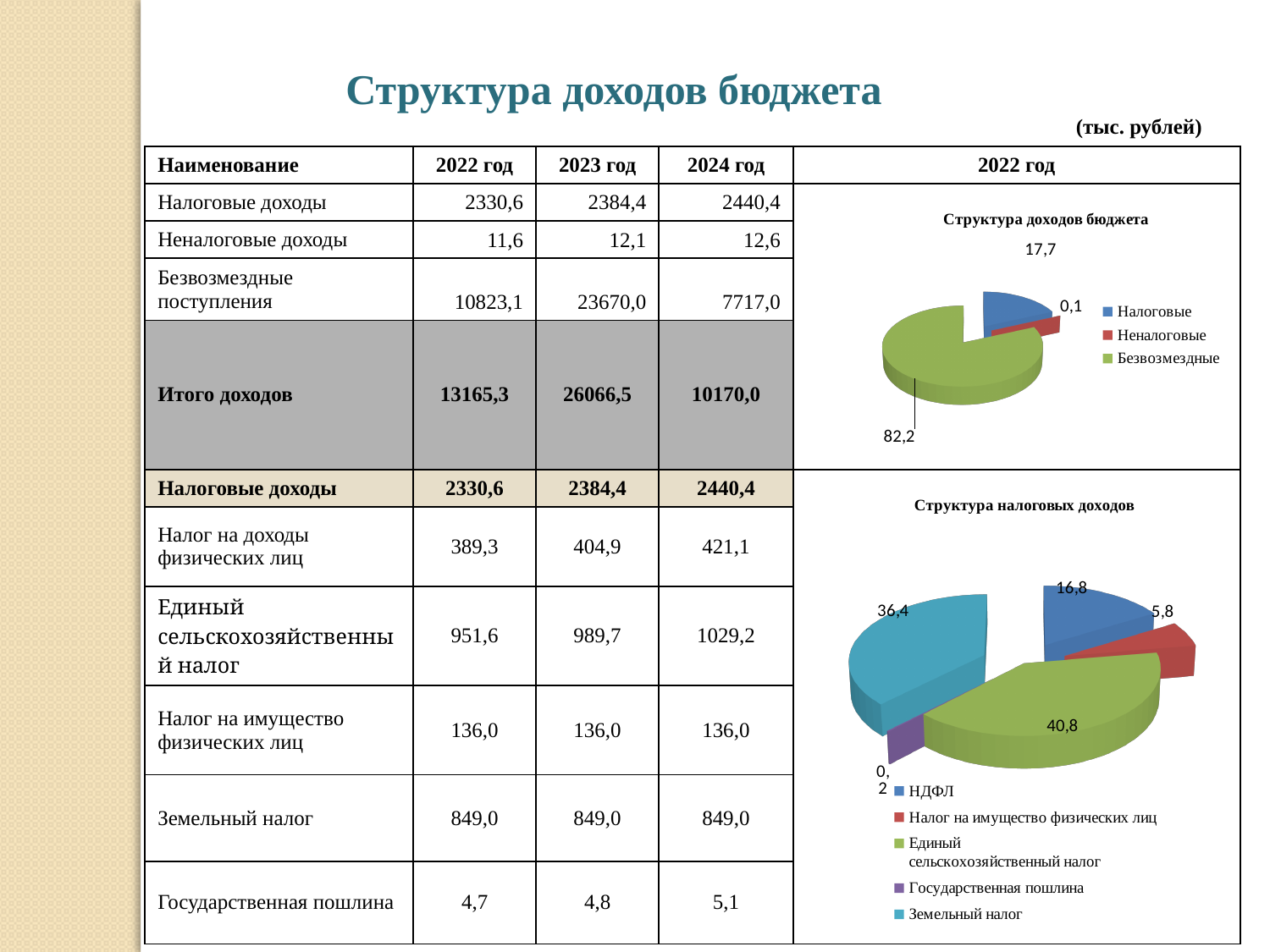
In the bottom pie chart "Структура налоговых доходов", what is the value shown for Земельный налог? 36,4 What kind of chart is the top chart titled "Структура доходов бюджета"? pie chart How many categories does the legend of the top pie chart "Структура доходов бюджета" list? 3 In the bottom pie chart "Структура налоговых доходов", what is the value shown for Единый сельскохозяйственный налог? 40,8 How many categories does the legend of the bottom pie chart "Структура налоговых доходов" list? 5 In the bottom pie chart "Структура налоговых доходов", which category has the largest slice? Единый сельскохозяйственный налог In the top pie chart "Структура доходов бюджета", what is the value shown for Безвозмездные? 82,2 In the top pie chart "Структура доходов бюджета", what is the value shown for Налоговые? 17,7 In the bottom pie chart "Структура налоговых доходов", what is the difference between the values for Единый сельскохозяйственный налог and Земельный налог? 4,4 In the top pie chart "Структура доходов бюджета", which category has the smallest slice? Неналоговые In the bottom pie chart "Структура налоговых доходов", which is larger: НДФЛ or Налог на имущество физических лиц? НДФЛ In the bottom pie chart "Структура налоговых доходов", what is the value shown for НДФЛ? 16,8